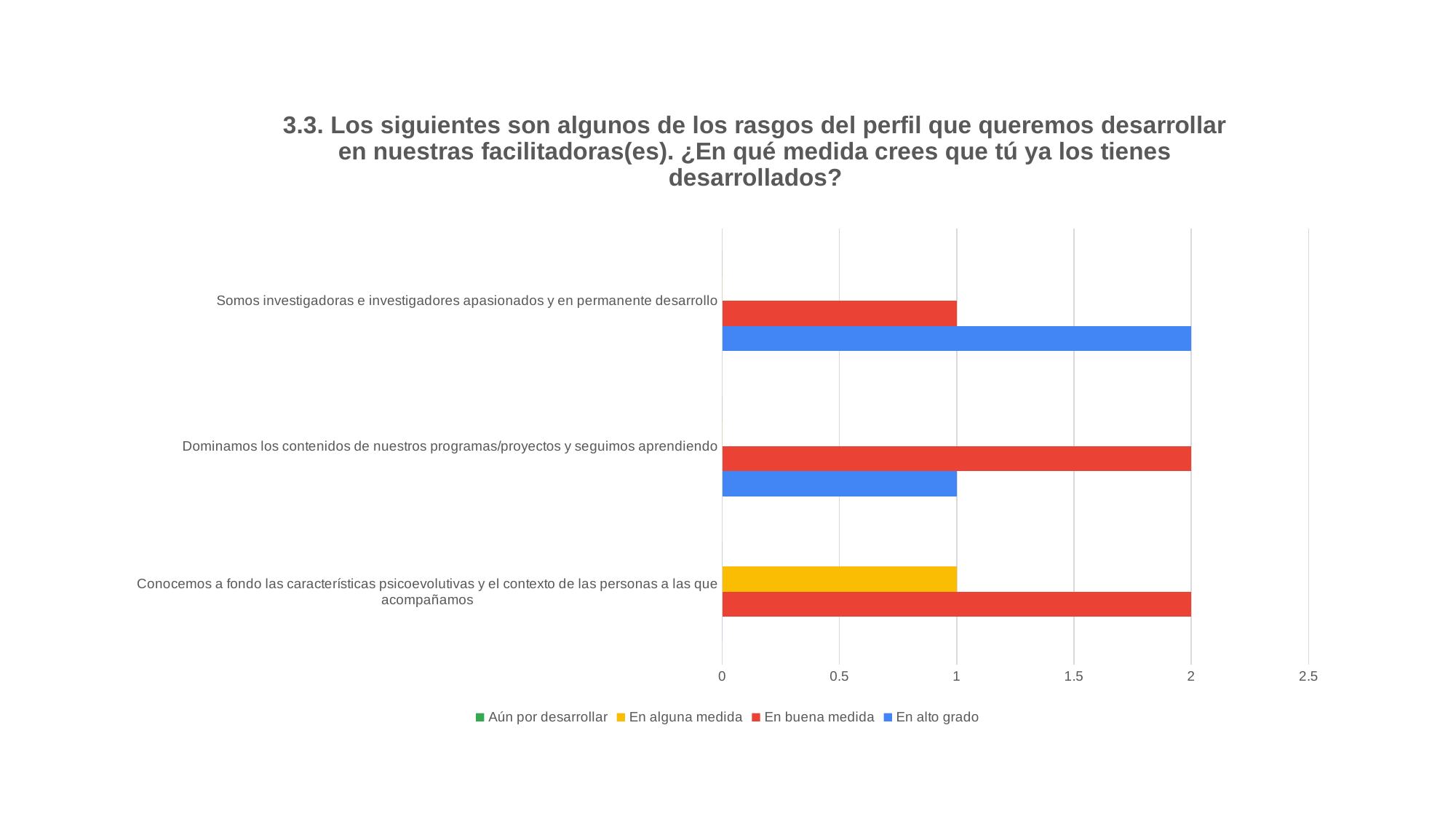
What is the value of 'En alguna medida' for 'Conocemos a fondo las características psicoevolutivas y el contexto de las personas a las que acompañamos'? 1 How many categories are plotted on the chart? 3 What is the value of 'En alto grado' for 'Somos investigadoras e investigadores apasionados y en permanente desarrollo'? 2 What is the value of 'En buena medida' for 'Somos investigadoras e investigadores apasionados y en permanente desarrollo'? 1 For 'Dominamos los contenidos de nuestros programas/proyectos y seguimos aprendiendo', which is larger: 'En buena medida' or 'En alto grado'? En buena medida Which category has the highest value for 'En alto grado'? Somos investigadoras e investigadores apasionados y en permanente desarrollo What is the value of 'En alto grado' for 'Dominamos los contenidos de nuestros programas/proyectos y seguimos aprendiendo'? 1 What is the difference between 'En alto grado' and 'En buena medida' for 'Somos investigadoras e investigadores apasionados y en permanente desarrollo'? 1 How many series does the legend list? 4 Which legend entry is shown in yellow? En alguna medida What is the value of 'En buena medida' for 'Dominamos los contenidos de nuestros programas/proyectos y seguimos aprendiendo'? 2 What kind of chart is shown on the slide? Bar chart